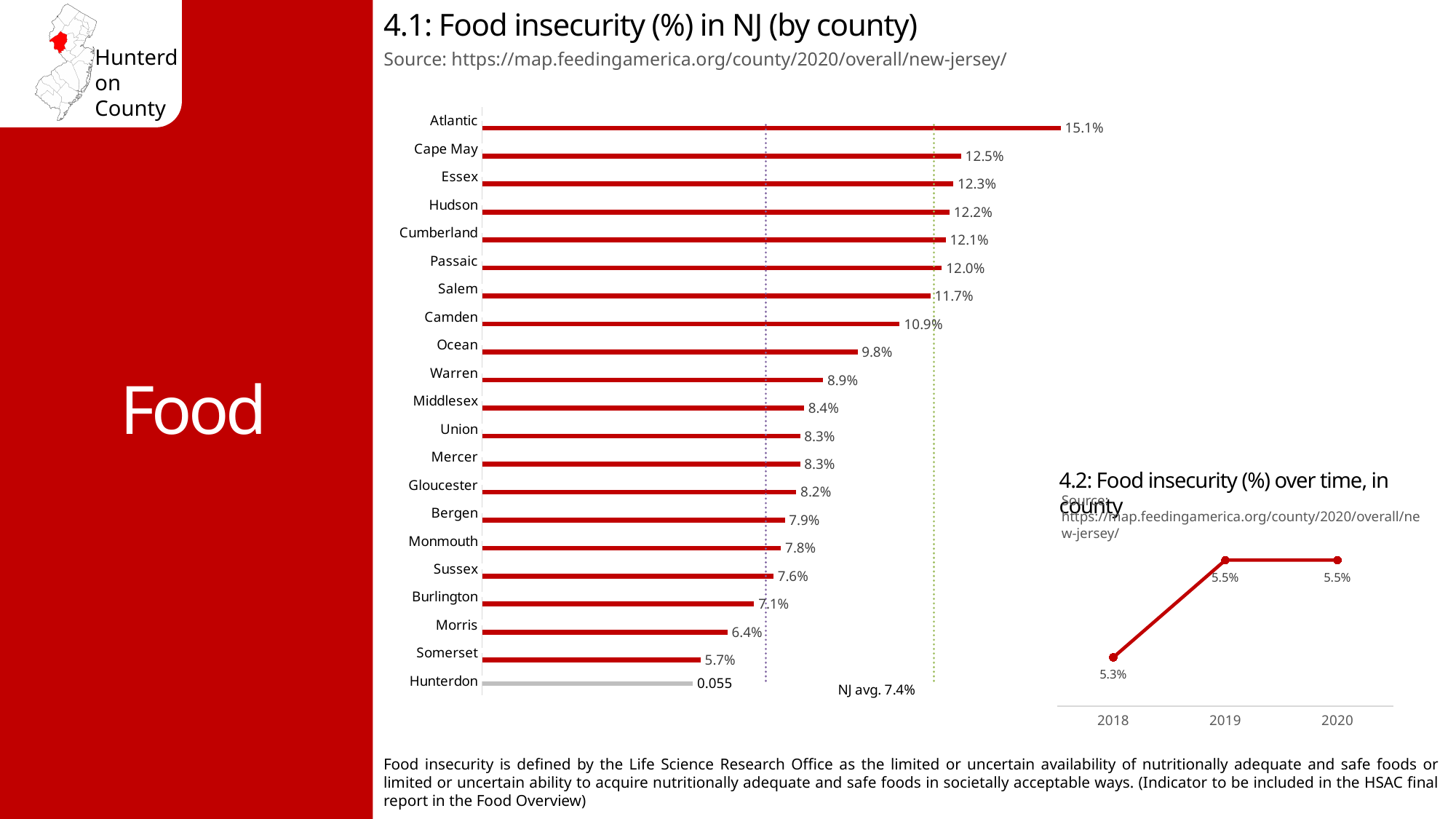
In chart 4.1 (Food insecurity (%) in NJ by county), which county has the lowest food insecurity? Hunterdon What kind of chart is chart 4.1 (Food insecurity (%) in NJ by county)? Bar chart In chart 4.1 (Food insecurity (%) in NJ by county), what is the value for Somerset? 5.7% In chart 4.1 (Food insecurity (%) in NJ by county), what NJ average is labelled on the chart? 7.4% In chart 4.1 (Food insecurity (%) in NJ by county), what is the value for Atlantic? 15.1% In chart 4.1 (Food insecurity (%) in NJ by county), which is larger, Ocean or Warren? Ocean In chart 4.2 (Food insecurity (%) over time, in county), how many data points are plotted? 3 In chart 4.1 (Food insecurity (%) in NJ by county), which county has the highest food insecurity? Atlantic In chart 4.1 (Food insecurity (%) in NJ by county), what is the value for Camden? 10.9% In chart 4.1 (Food insecurity (%) in NJ by county), what is the difference between Atlantic and Cape May? 2.6% In chart 4.2 (Food insecurity (%) over time, in county), what is the value for 2018? 5.3% In chart 4.1 (Food insecurity (%) in NJ by county), how many counties are shown? 21